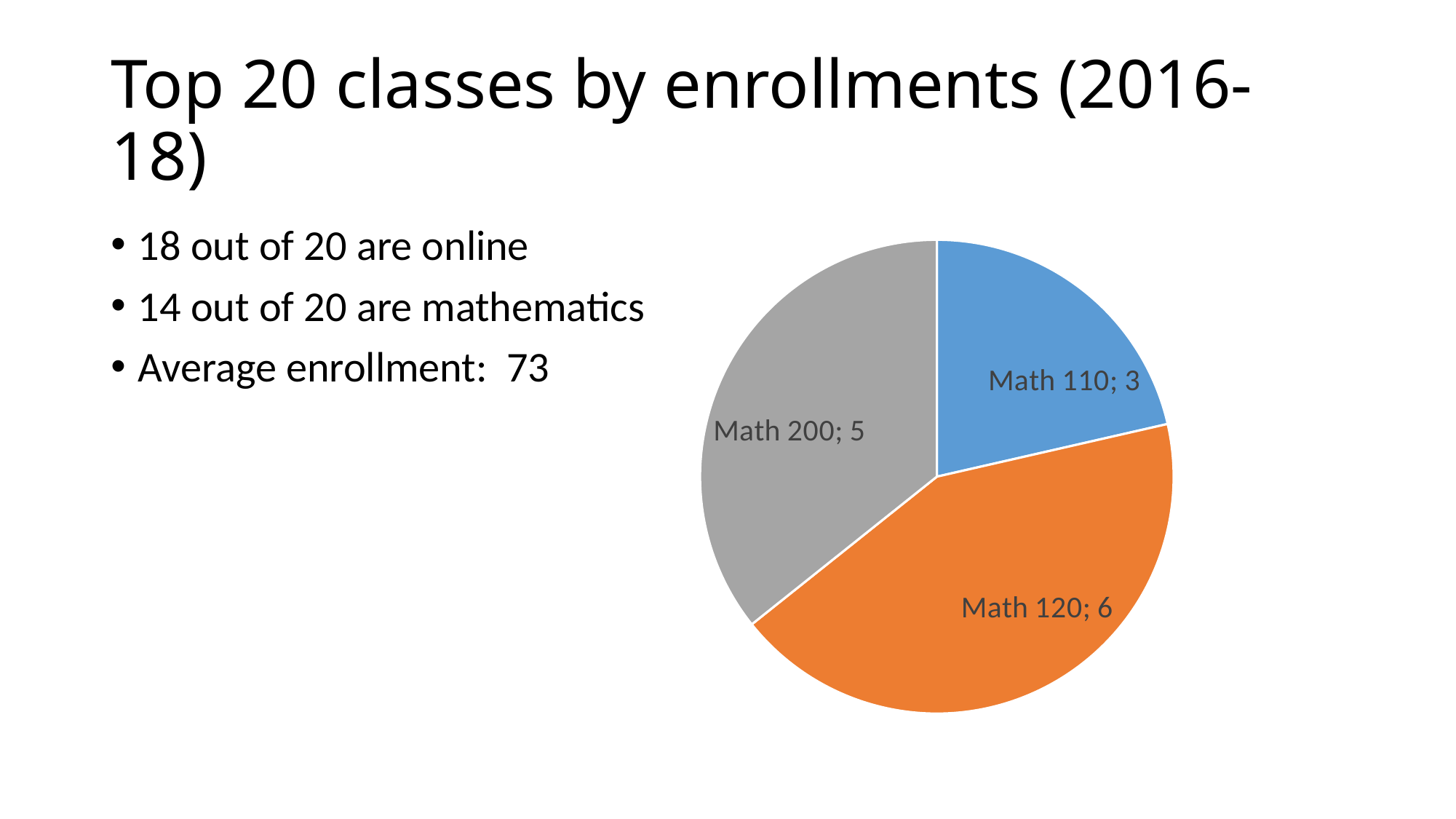
How many slices does the pie chart have? 3 What colour is the Math 120 slice in the pie chart? orange What type of chart is shown on the slide? pie chart What is the value for Math 120 in the pie chart? 6 Which slice of the pie chart has the smallest value? Math 110 Which slice of the pie chart has the largest value? Math 120 Which is larger, the value for Math 200 or the value for Math 110? Math 200 What is the total of all slices in the pie chart? 14 What is the difference between the values for Math 120 and Math 110? 3 What is the value for Math 200 in the pie chart? 5 What is the value for Math 110 in the pie chart? 3 What colour is the Math 200 slice in the pie chart? grey